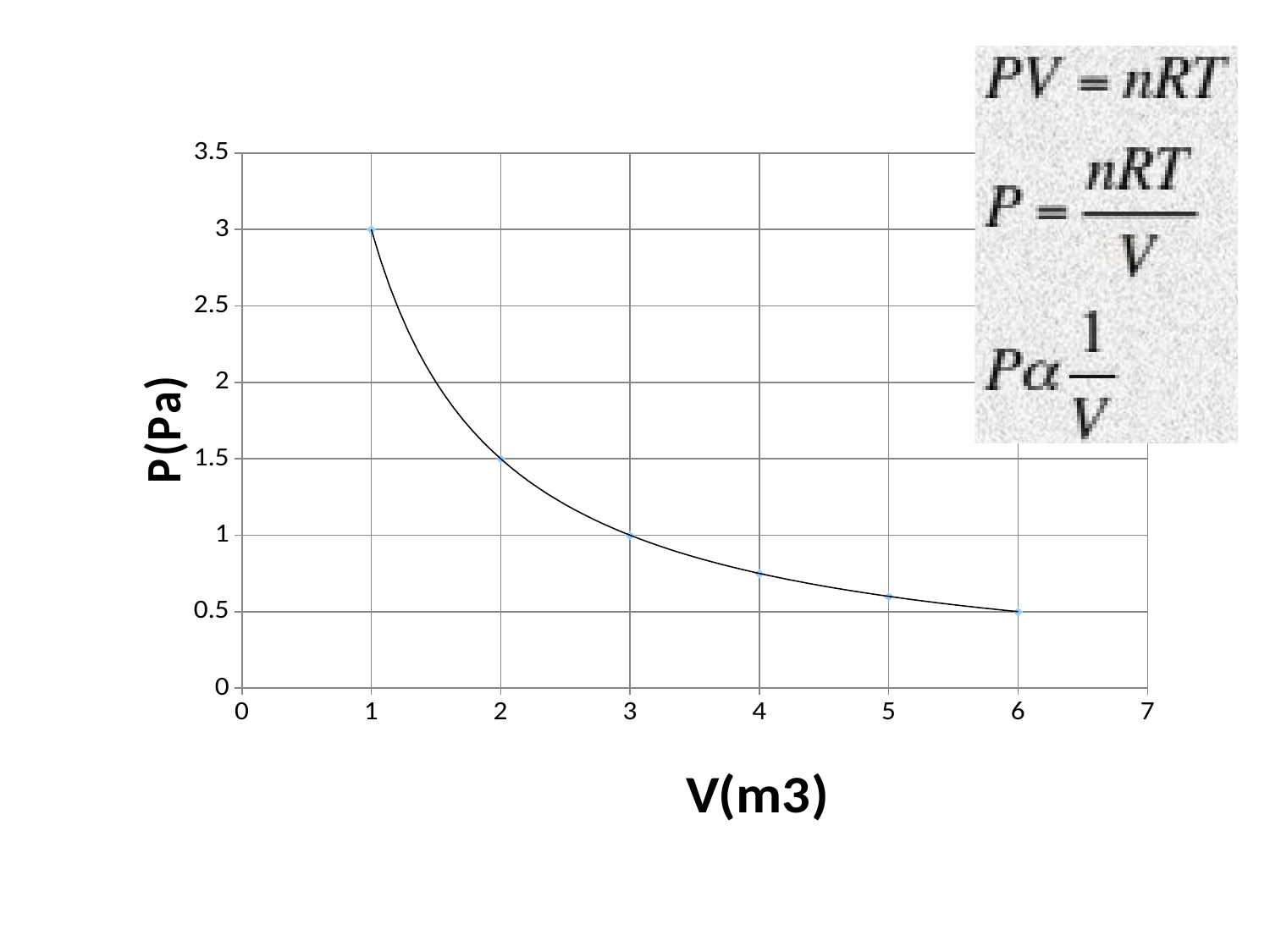
Is the value of P at V = 5 greater or less than 1? less What is the value of P when V is 1? 3 What is the difference between P at V = 1 and P at V = 2? 1.5 Does P rise or fall as V increases along the x axis? fall Is the value of P at V = 4 greater or less than 1? less What is the value of P when V is 3? 1 Which is larger, P at V = 2 or P at V = 3? P at V = 2 How many data points are plotted on the chart? 6 At which value of V is P highest? 1 At which value of V is P lowest? 6 What is the value of P when V is 6? 0.5 What is the value of P when V is 2? 1.5